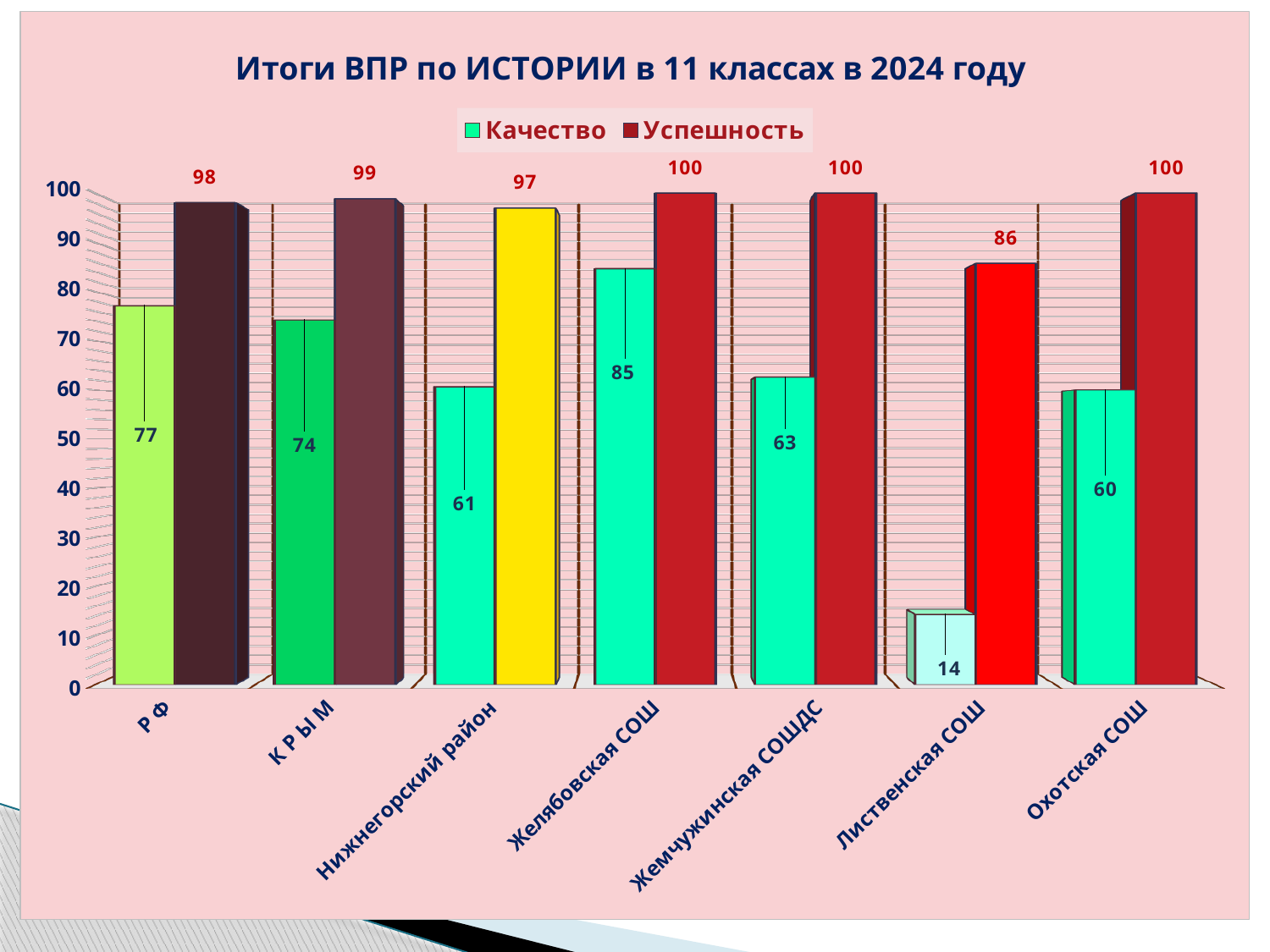
What is the Успешность value for Лиственская СОШ? 86 What is the Качество value for Желябовская СОШ? 85 Is the Качество value for Жемчужинская СОШДС greater or less than 70? less Which is larger, the Качество value for РФ or the Качество value for КРЫМ? РФ What is the title of the chart? Итоги ВПР по ИСТОРИИ в 11 классах в 2024 году What is the difference between the Успешность and Качество values for Лиственская СОШ? 72 How many series does the legend list? 2 How many categories are shown on the x axis? 7 What is the Качество value for Нижнегорский район? 61 What kind of chart is shown on the slide? bar chart Which category has the highest Качество value? Желябовская СОШ Which category has the lowest Качество value? Лиственская СОШ